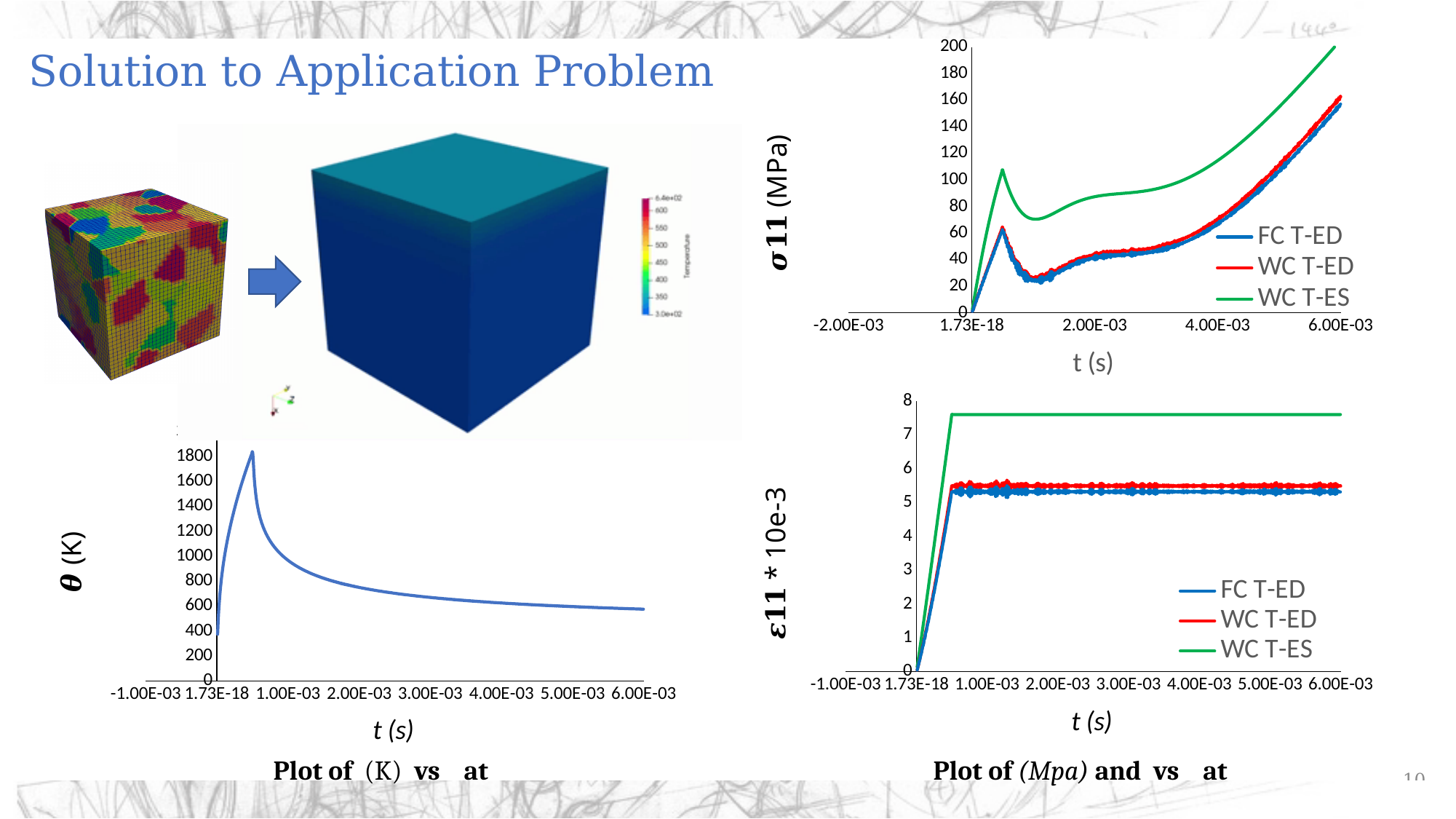
What is the y-axis label of the bottom-left chart? θ (K) On the bottom-right chart (ε11 vs t), which series has the highest plateau value? WC T-ES On the bottom-right chart (ε11 vs t), is the plateau value of WC T-ES greater or less than 7? greater On the bottom-left chart (θ vs t), is the peak value greater or less than 1600? greater What kind of chart is the top-right chart (σ11 vs t)? line chart On the top-right chart (σ11 vs t), how many series does the legend list? 3 On the top-right chart (σ11 vs t), is the early peak value of WC T-ES greater or less than 80? greater On the bottom-right chart (ε11 vs t), what colour is the WC T-ES line? green On the top-right chart (σ11 vs t), which series reaches the highest value at 6.00E-03 s? WC T-ES On the bottom-left chart (θ vs t), do the values rise or fall after the peak as t increases? fall On the top-right chart (σ11 vs t), do the values of WC T-ES rise or fall between 4.00E-03 and 6.00E-03 s? rise